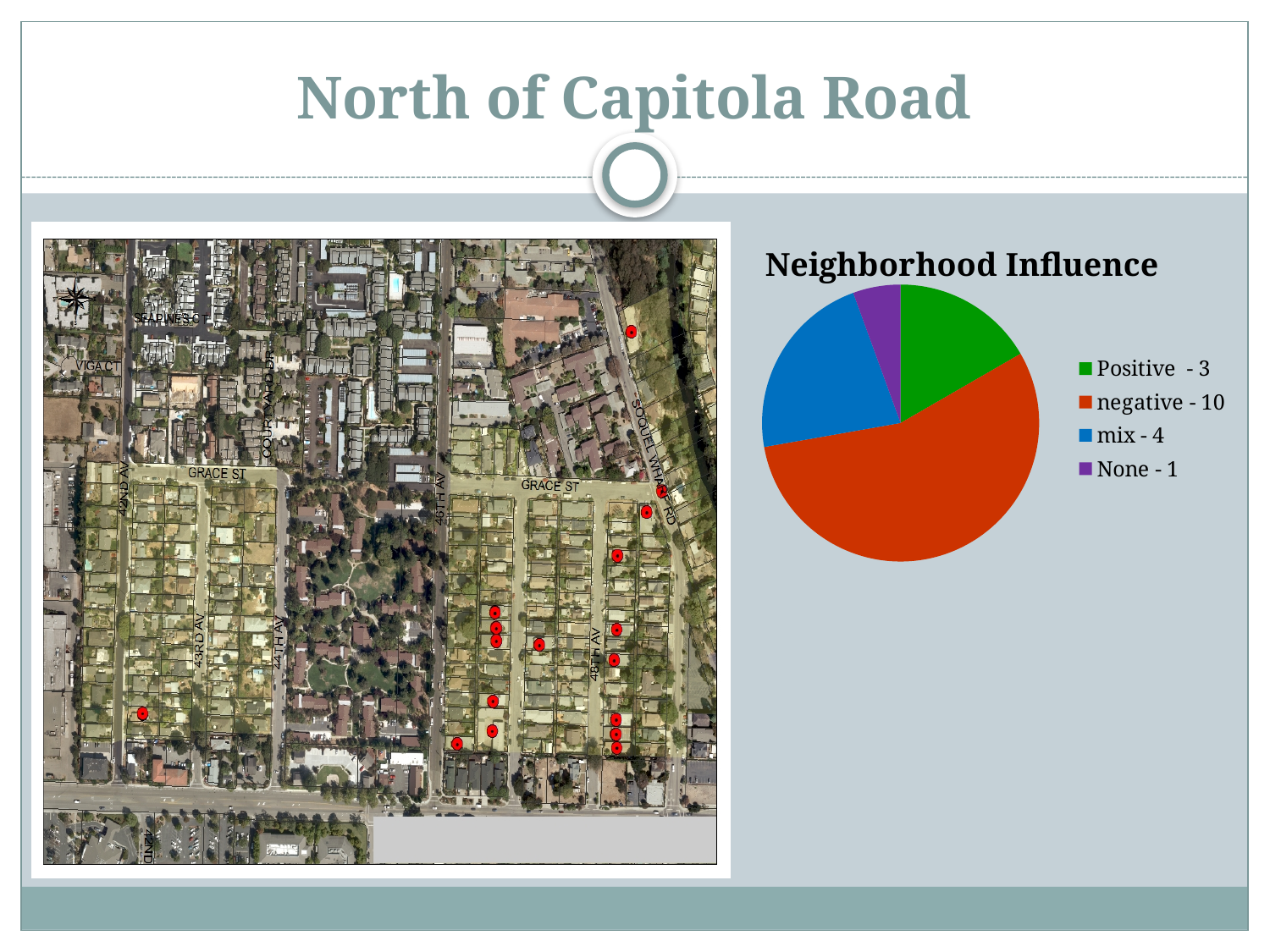
How many entries does the legend list? 4 What is the value for the mix category? 4 What colour is the slice for the negative category? red How many categories does the pie chart have? 4 Which category has the largest slice of the pie? negative Which is larger, the value for mix or the value for Positive? mix What is the value for the negative category? 10 What type of chart is shown on the slide? pie chart What is the value for the Positive category? 3 Which category has the smallest slice of the pie? None What is the title of the chart? Neighborhood Influence What is the difference between the negative and mix values? 6